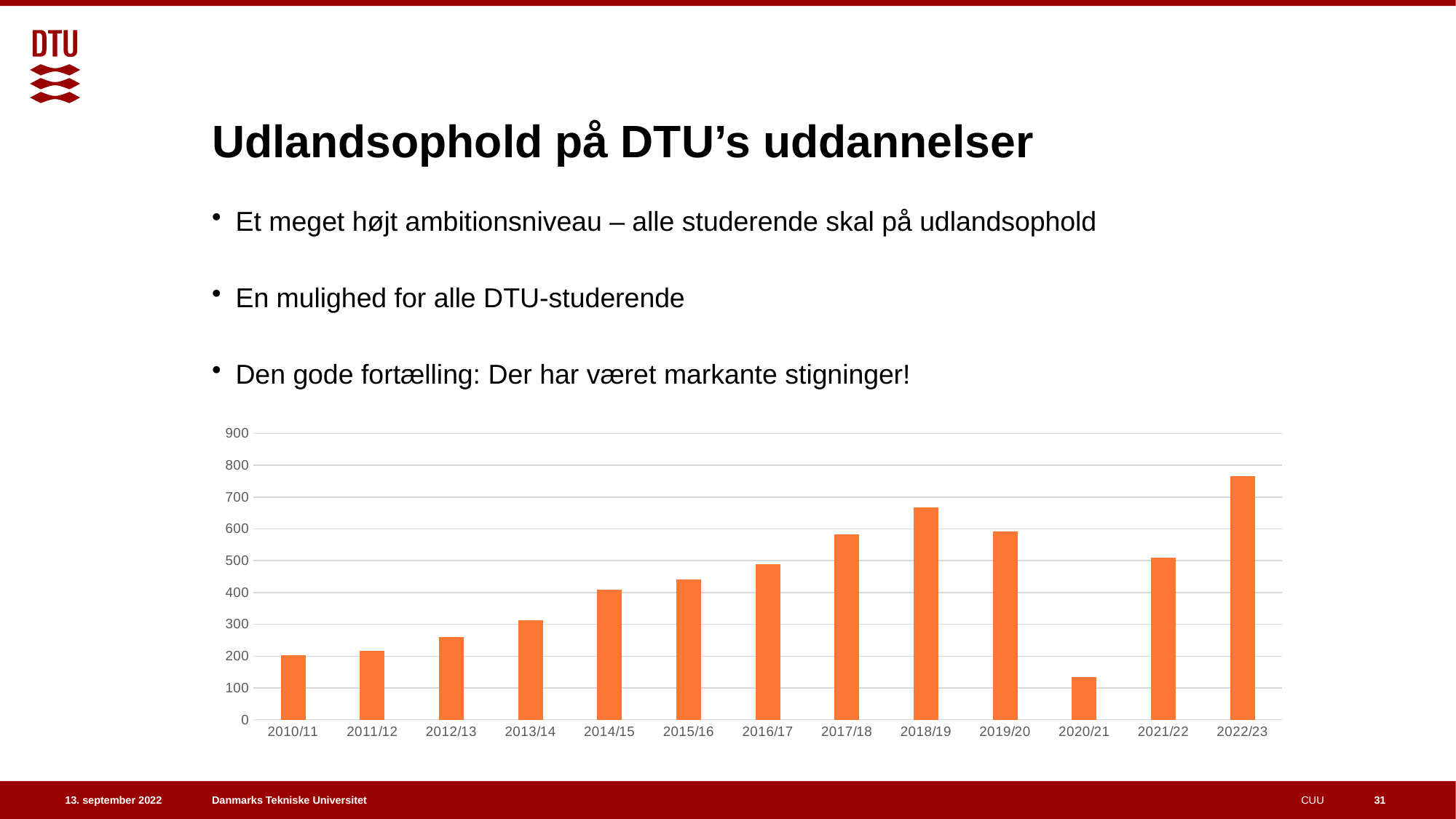
Which academic year has the lowest bar in the chart? 2020/21 Is the value for 2022/23 greater or less than 700? greater Overall, do the values rise or fall from 2010/11 to 2022/23? rise How many academic years are shown on the x axis of the chart? 13 Which is larger, the value for 2018/19 or the value for 2019/20? 2018/19 What kind of chart is shown on the slide? bar chart Which academic year has the highest bar in the chart? 2022/23 Is the value for 2020/21 greater or less than 200? less Is the value for 2013/14 greater or less than 400? less Which is larger, the value for 2021/22 or the value for 2020/21? 2021/22 What colour are the bars in the chart? orange